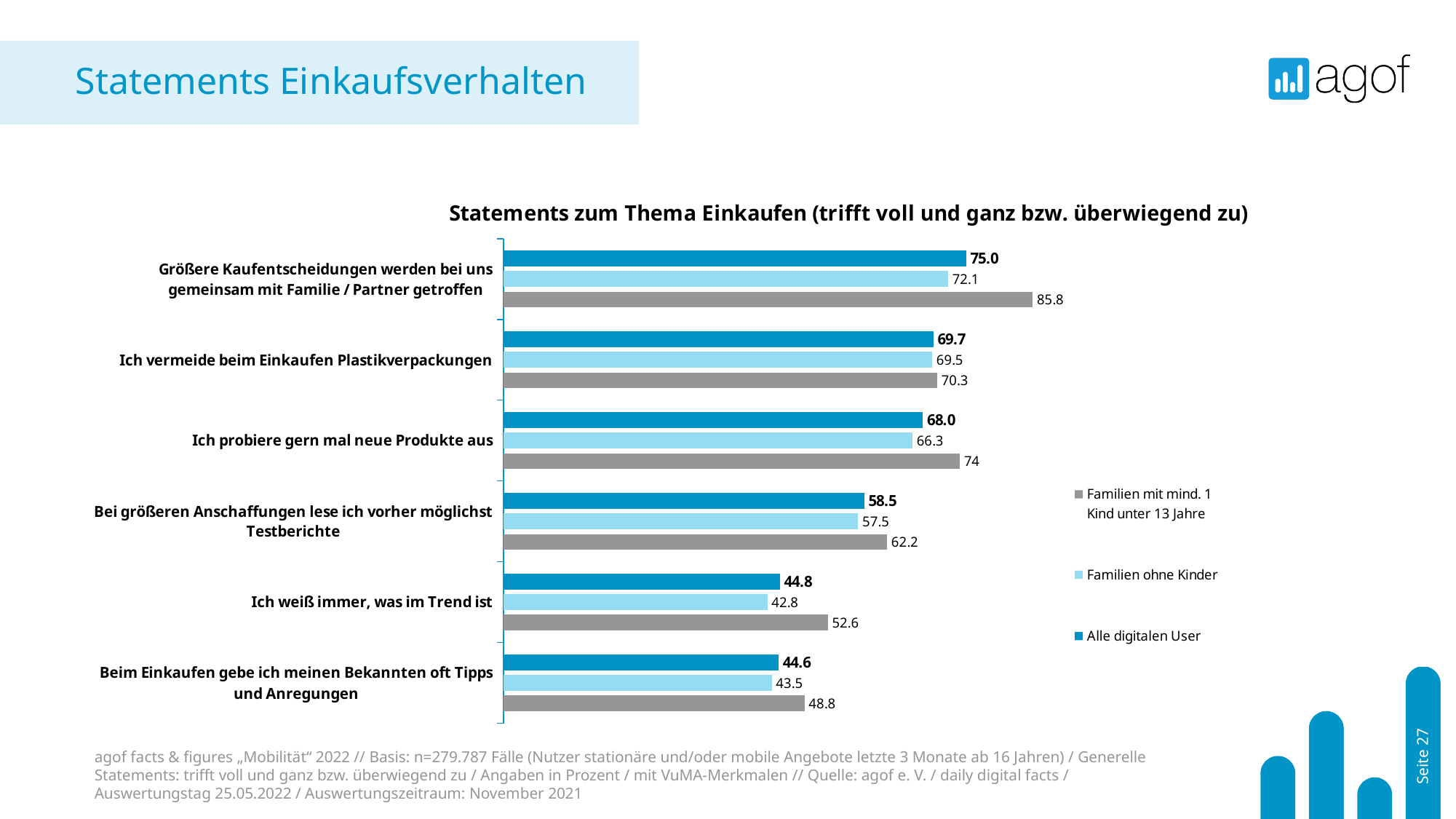
What is the difference between "Familien mit mind. 1 Kind unter 13 Jahre" and "Alle digitalen User" for the statement "Größere Kaufentscheidungen werden bei uns gemeinsam mit Familie / Partner getroffen"? 10.8 What is the title of the chart? Statements zum Thema Einkaufen (trifft voll und ganz bzw. überwiegend zu) How many statements are shown in the chart? 6 How many series does the legend list? 3 Which statement has the lowest value for "Alle digitalen User"? Beim Einkaufen gebe ich meinen Bekannten oft Tipps und Anregungen What is the value for "Familien mit mind. 1 Kind unter 13 Jahre" for the statement "Ich probiere gern mal neue Produkte aus"? 74 Which statement has the highest value for "Familien mit mind. 1 Kind unter 13 Jahre"? Größere Kaufentscheidungen werden bei uns gemeinsam mit Familie / Partner getroffen What is the value for "Familien ohne Kinder" for the statement "Ich weiß immer, was im Trend ist"? 42.8 What is the value for "Familien ohne Kinder" for the statement "Ich vermeide beim Einkaufen Plastikverpackungen"? 69.5 For the statement "Ich weiß immer, was im Trend ist", which series has the larger value: "Familien mit mind. 1 Kind unter 13 Jahre" or "Familien ohne Kinder"? Familien mit mind. 1 Kind unter 13 Jahre What is the value for "Alle digitalen User" for the statement "Größere Kaufentscheidungen werden bei uns gemeinsam mit Familie / Partner getroffen"? 75.0 What kind of chart is shown on the slide? Bar chart